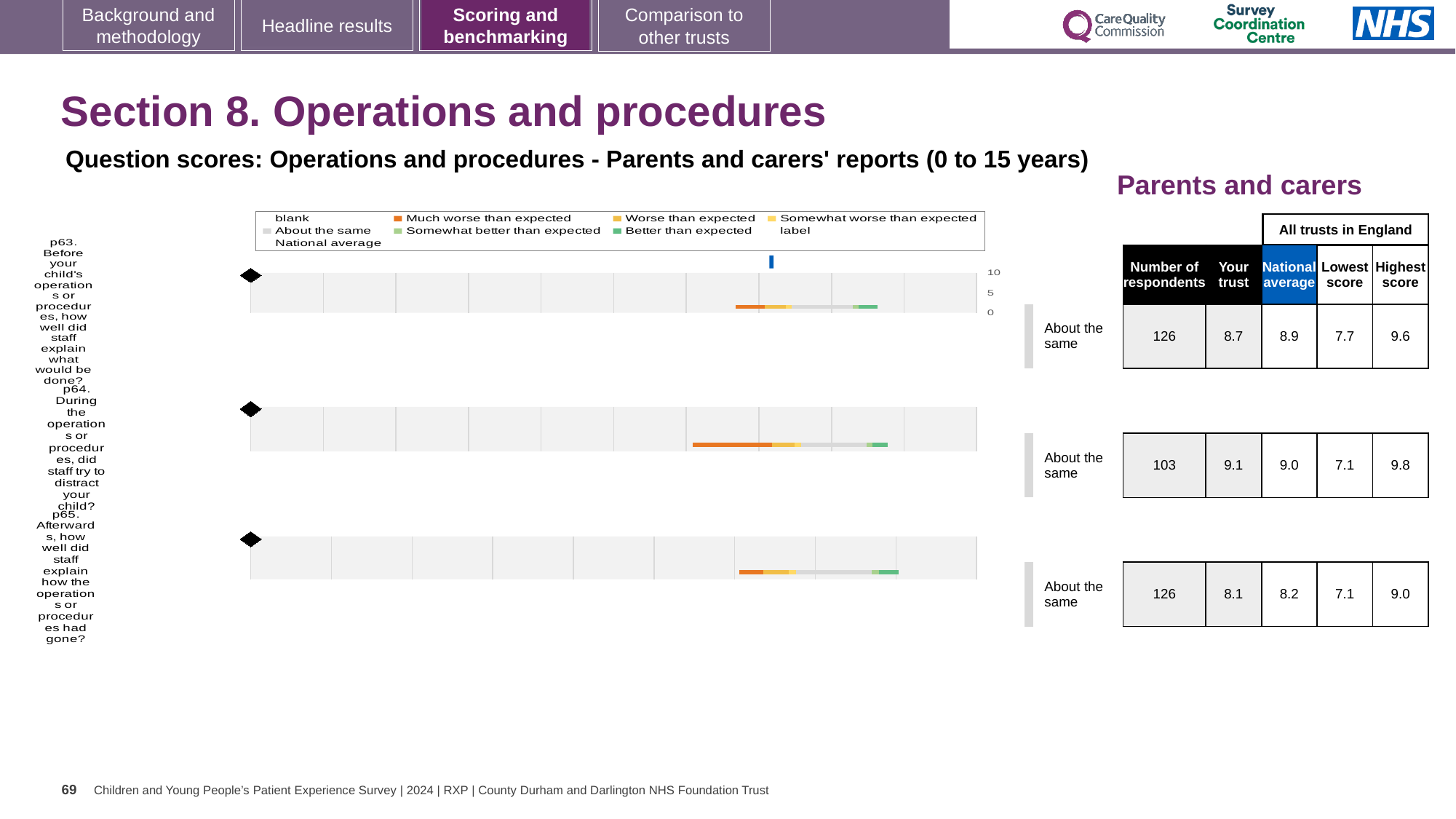
What kind of chart is used to show the question scores for p63, p64 and p65? bar chart For p64 (did staff try to distract your child during the operation), what is the national average score? 9.0 What benchmark category is shown next to the p65 chart? About the same For p65 (how well staff explained how the operation had gone), how many respondents are shown? 126 How many questions (p63, p64, p65) are plotted on the slide? 3 Which of the three questions has the lowest 'Your trust' score? p65 For p63 (how well staff explained what would be done before the operation), what is the 'Your trust' score shown in the table? 8.7 For p64, is the 'Your trust' score or the national average score larger? Your trust What is the highest score across all trusts in England for p64? 9.8 Which of the three questions has the highest 'Your trust' score? p64 What colour is used in the legend for 'Much worse than expected'? orange For p63, what is the difference between the highest score and the lowest score across all trusts in England? 1.9